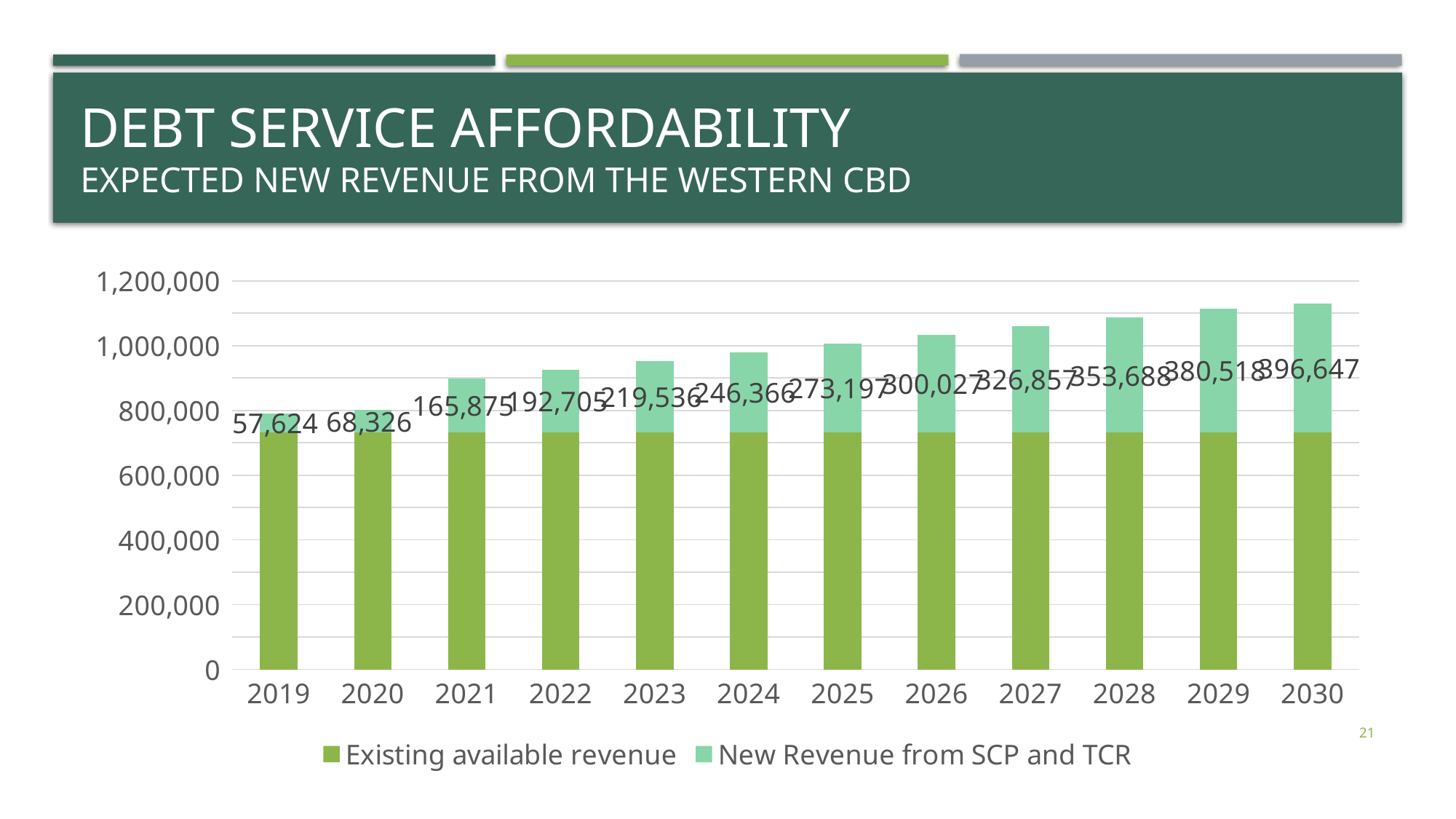
What is the value of New Revenue from SCP and TCR in 2019? 57,624 Is the Existing available revenue in 2019 greater or less than 600,000? greater Which year has the highest New Revenue from SCP and TCR? 2030 How many years are shown on the x axis? 12 Which year has the lowest New Revenue from SCP and TCR? 2019 What is the value of New Revenue from SCP and TCR in 2025? 273,197 Is the New Revenue from SCP and TCR larger in 2021 or in 2020? 2021 How many series does the legend list? 2 What is the difference in New Revenue from SCP and TCR between 2020 and 2019? 10,702 What is the value of New Revenue from SCP and TCR in 2030? 396,647 Does the New Revenue from SCP and TCR rise or fall from 2019 to 2030? rise What is the difference in New Revenue from SCP and TCR between 2030 and 2019? 339,023